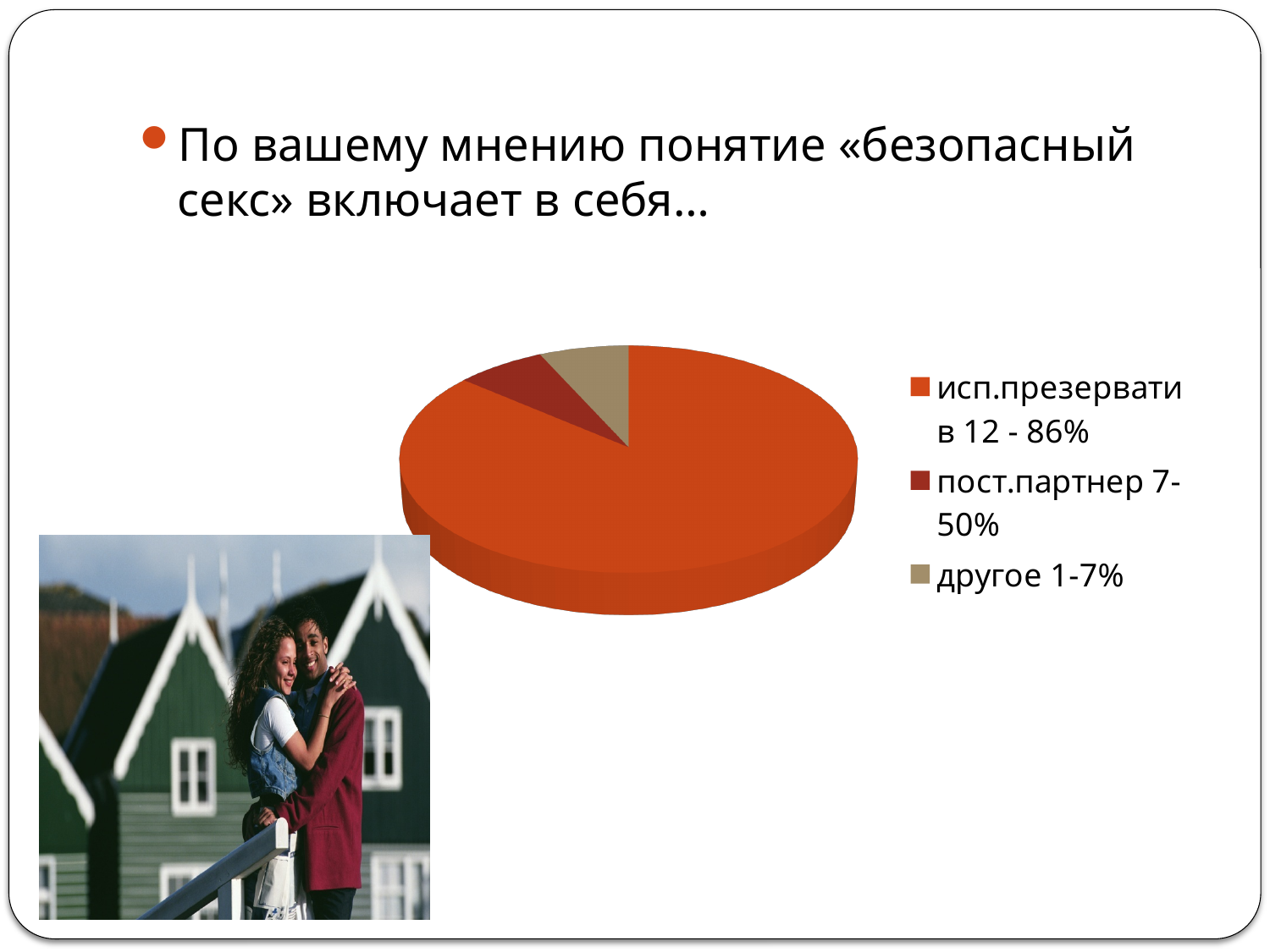
Which slice is larger: "исп.презерватив 12 - 86%" or "пост.партнер 7-50%"? исп.презерватив 12 - 86% Which slice is larger: "исп.презерватив 12 - 86%" or "другое 1-7%"? исп.презерватив 12 - 86% Which slice of the pie chart is the largest? исп.презерватив 12 - 86% What kind of chart is shown on the slide? pie chart What is the first entry listed in the legend of the pie chart? исп.презерватив 12 - 86% How many slices does the pie chart have? 3 How many entries does the legend of the pie chart list? 3 What colour is the slice for "другое 1-7%" in the pie chart? tan (beige)